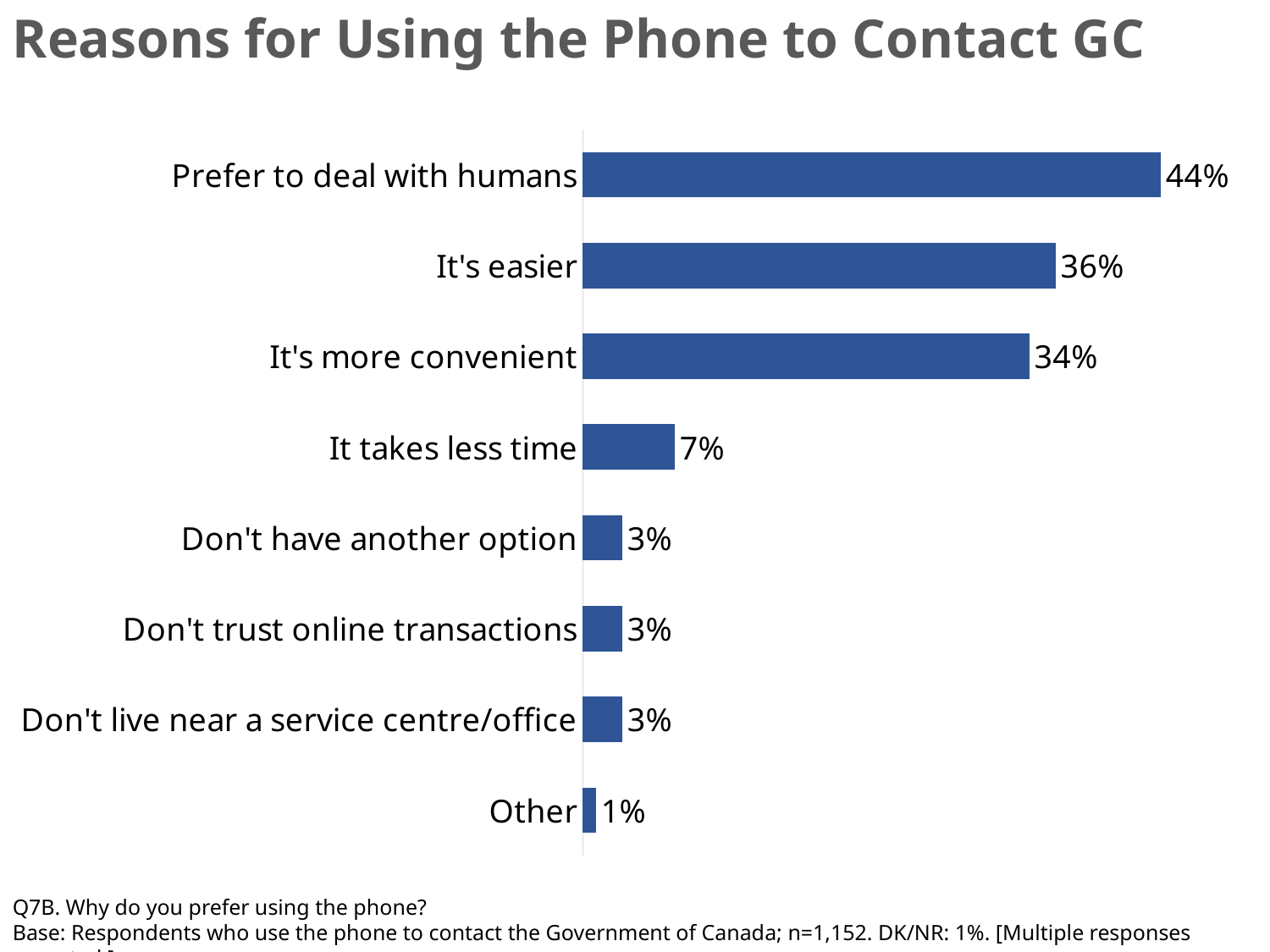
Which is larger, "It's easier" or "It's more convenient"? It's easier What is the value for "Other"? 1% What is the difference between "It's more convenient" and "It takes less time"? 27 percentage points How many reasons are shown in the chart? 8 What is the title of the chart? Reasons for Using the Phone to Contact GC Which reason has the highest percentage? Prefer to deal with humans What percentage of respondents said it takes less time? 7% Which reason has the lowest percentage? Other What kind of chart is shown on the slide? Bar chart What percentage of respondents said they prefer to deal with humans? 44% What is the difference between "Prefer to deal with humans" and "It's easier"? 8 percentage points What is the value for "It's more convenient"? 34%